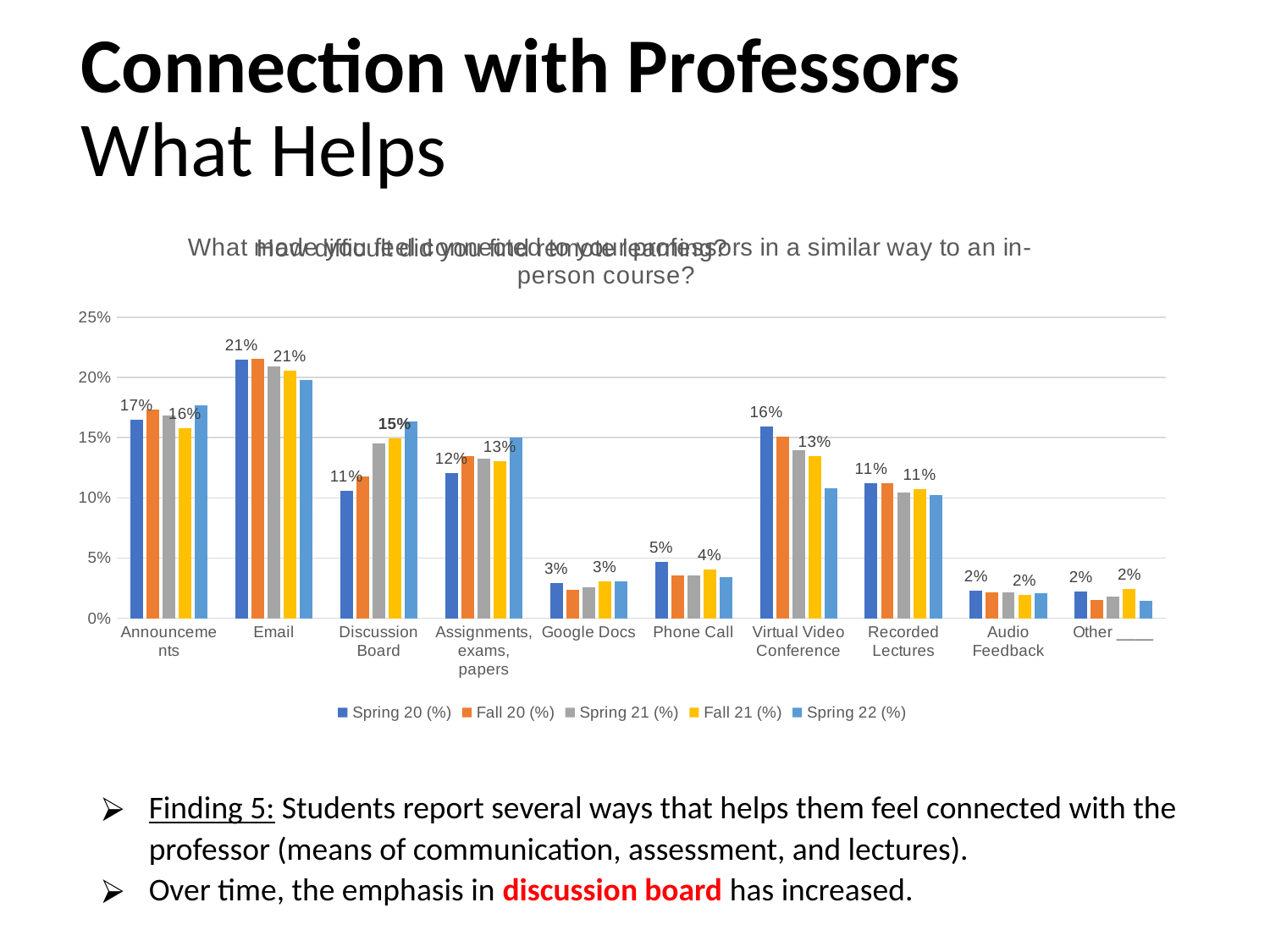
What is the Spring 20 (%) value for Virtual Video Conference? 16% What is the Spring 20 (%) value for Google Docs? 3% What is the Spring 20 (%) value for Announcements? 17% For Spring 20 (%), which is larger: Email or Announcements? Email What is the Spring 20 (%) value for Email? 21% How many series does the legend list? 5 How many categories are shown on the x axis? 10 What is the difference between the Spring 20 (%) values for Email and Announcements? 4% Is the Spring 22 (%) value for Virtual Video Conference greater or less than 15%? less Is the Spring 22 (%) value for Discussion Board greater or less than 15%? greater Which category has the highest Spring 20 (%) value? Email What is the Spring 20 (%) value for Phone Call? 5%